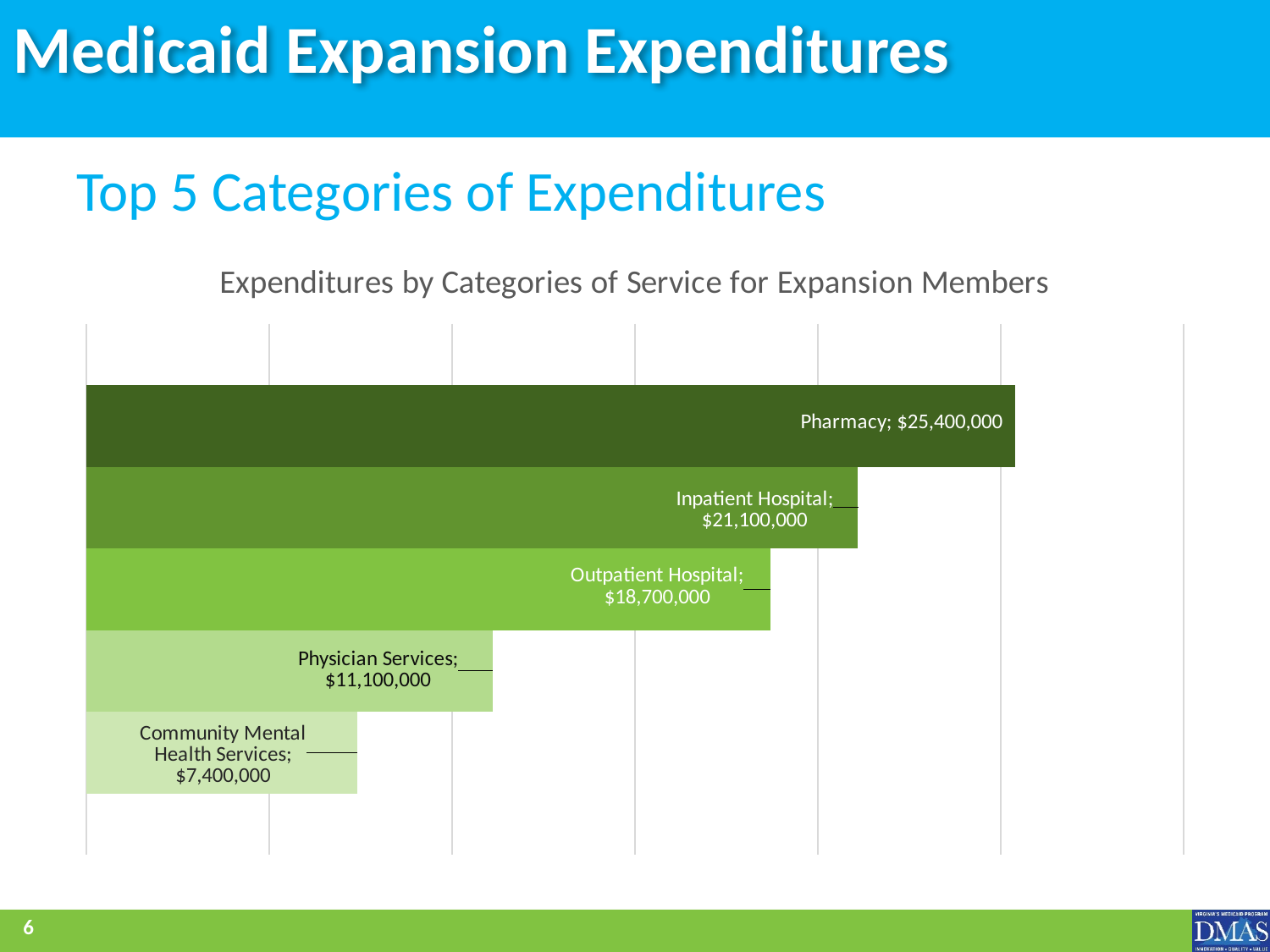
Which category has the lowest expenditure? Community Mental Health Services What is the difference between the Pharmacy and Inpatient Hospital expenditures? $4,300,000 Which category has the highest expenditure? Pharmacy What is the title of the chart? Expenditures by Categories of Service for Expansion Members What is the expenditure for Outpatient Hospital? $18,700,000 What is the expenditure for Pharmacy? $25,400,000 What kind of chart is shown on the slide? Bar chart What is the expenditure for Community Mental Health Services? $7,400,000 What is the expenditure for Inpatient Hospital? $21,100,000 How many categories of service are shown in the chart? 5 What is the expenditure for Physician Services? $11,100,000 Which is larger, the expenditure for Outpatient Hospital or for Physician Services? Outpatient Hospital